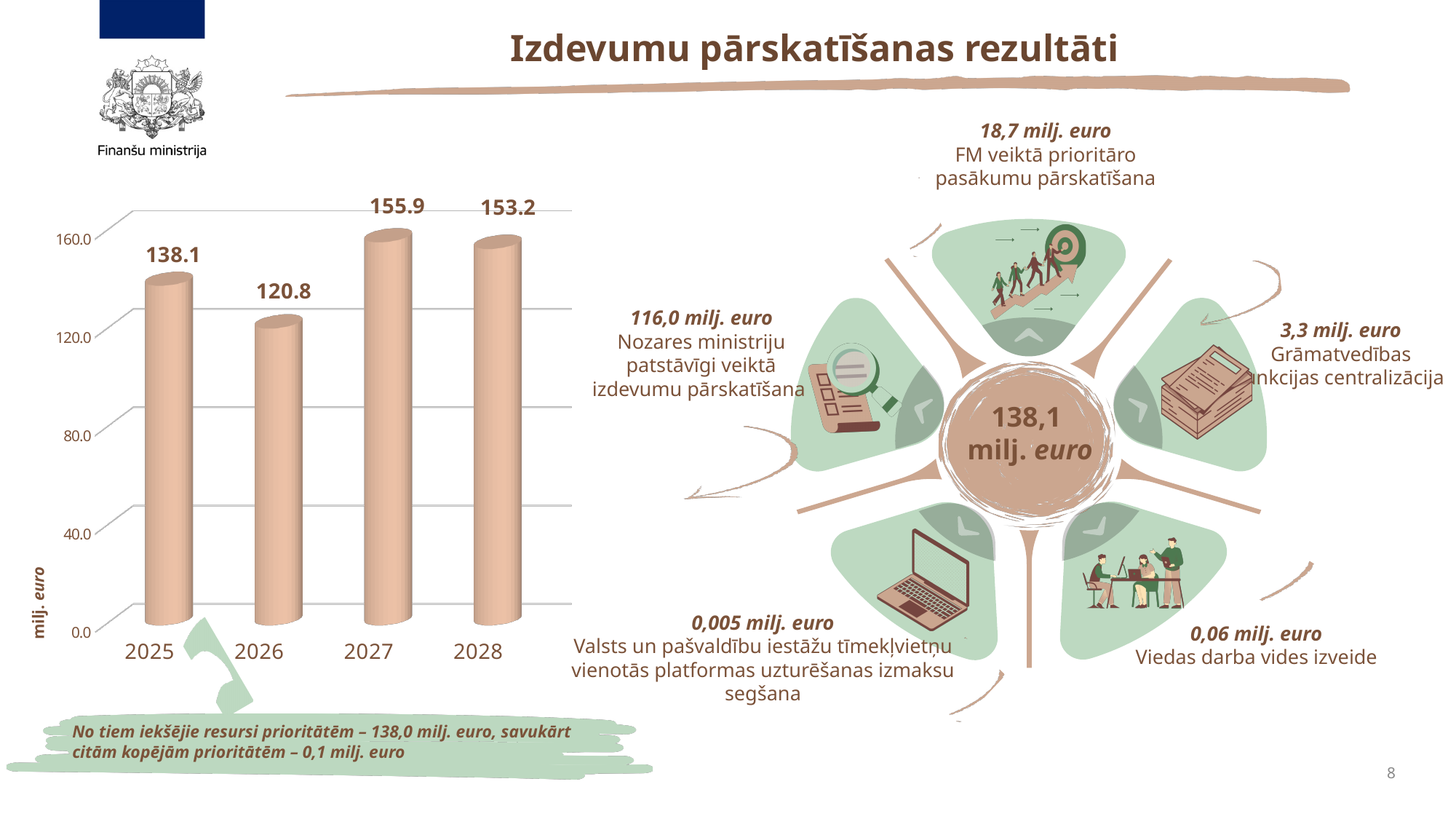
Which year has the lowest value in the bar chart? 2026 What is the difference between the values for 2027 and 2026 in the bar chart? 35.1 What is the value for 2028 in the bar chart? 153.2 Which is larger in the bar chart, the value for 2025 or the value for 2028? 2028 What kind of chart is shown on the left of the slide? bar chart What is the value for 2027 in the bar chart? 155.9 What is the difference between the values for 2025 and 2026 in the bar chart? 17.3 What unit is given on the vertical axis label of the bar chart? milj. euro What is the value for 2026 in the bar chart? 120.8 Which year has the highest value in the bar chart? 2027 How many years are shown on the x axis of the bar chart? 4 What is the value for 2025 in the bar chart? 138.1